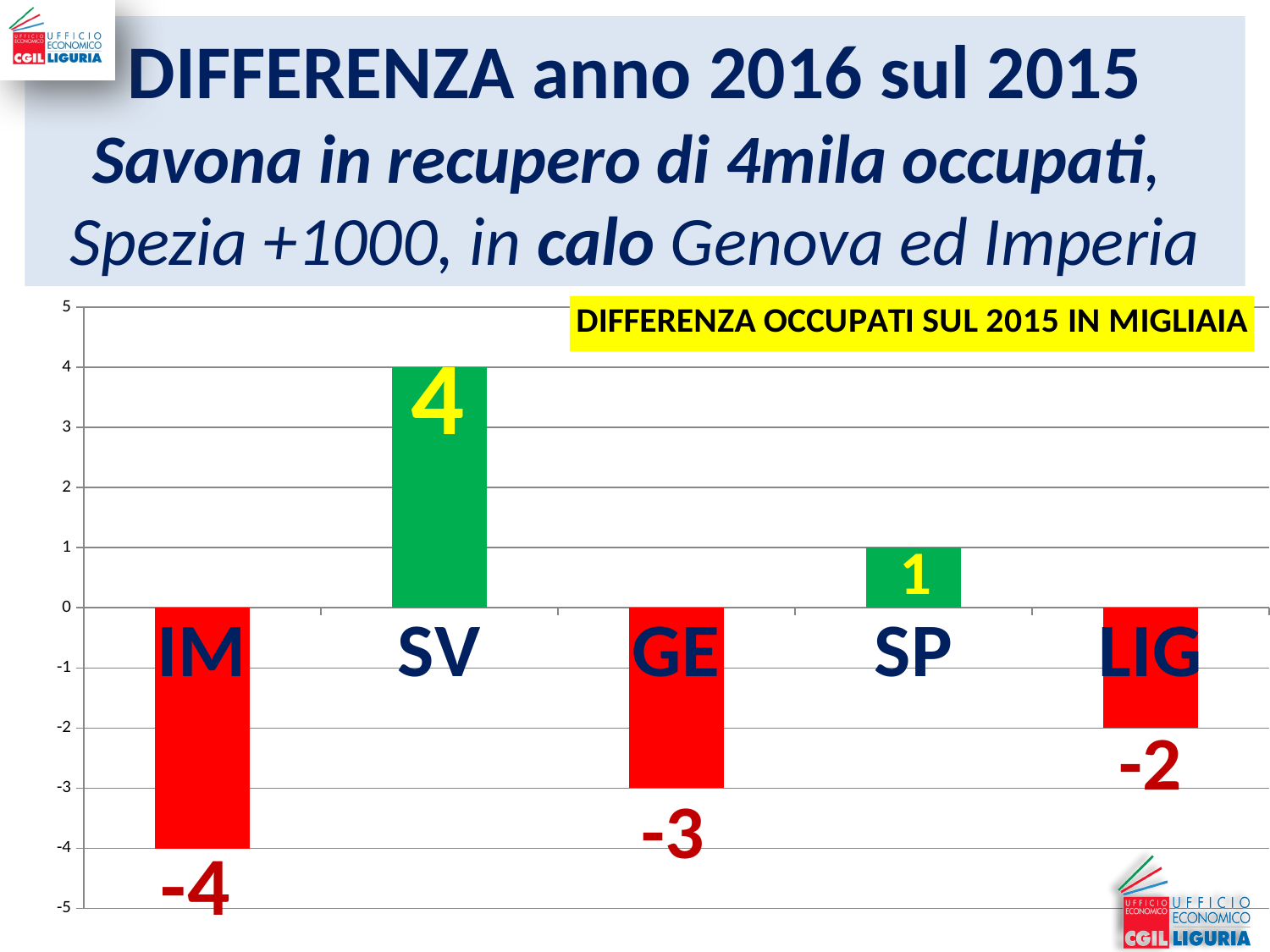
What is the value for IM? -4 What kind of chart is shown on the slide? bar chart What is the value for SP? 1 What is the difference between the values for SV and SP? 3 What is the value for LIG? -2 What is the title shown in the yellow box on the chart? DIFFERENZA OCCUPATI SUL 2015 IN MIGLIAIA Which category has the lowest value? IM How many categories are shown on the x axis? 5 Which is larger, the value for GE or the value for LIG? LIG Which category has the highest value? SV What is the value for SV? 4 What is the value for GE? -3